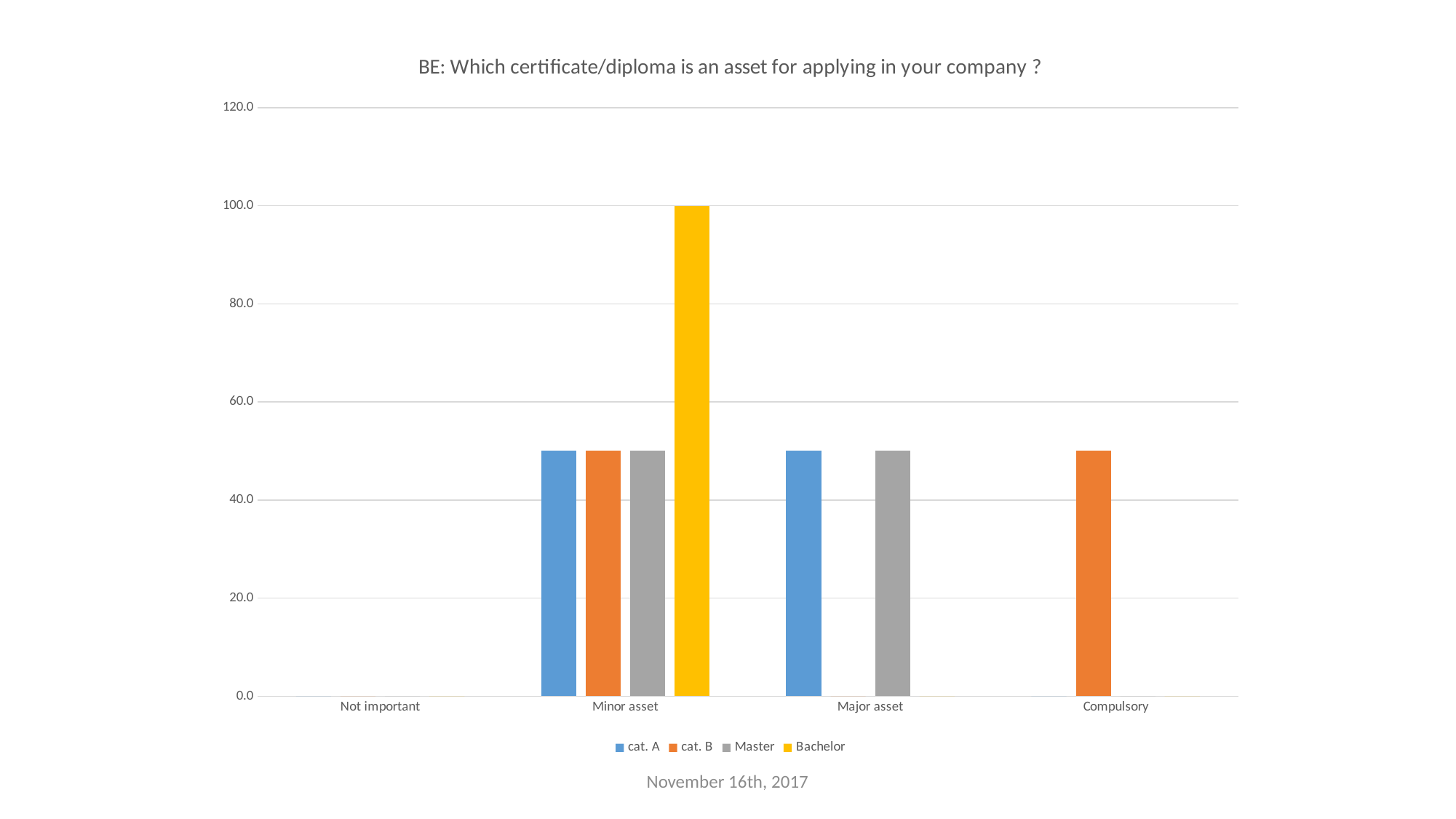
Is the value of cat. B for Compulsory greater or less than 60? less What is the title of the chart? BE: Which certificate/diploma is an asset for applying in your company ? How many categories are shown on the x axis? 4 What is the value of the Bachelor series for Minor asset? 100.0 In the Minor asset category, which is larger: the Bachelor bar or the cat. A bar? Bachelor Is the value of Master for Minor asset greater or less than 60? less What kind of chart is shown on the slide? bar chart Is the value of cat. A for Major asset greater or less than 40? greater For which category does the Bachelor series reach its highest value? Minor asset Which series has the highest bar in the Minor asset category? Bachelor How many series does the legend list? 4 Which colour represents the Bachelor series in the legend? yellow